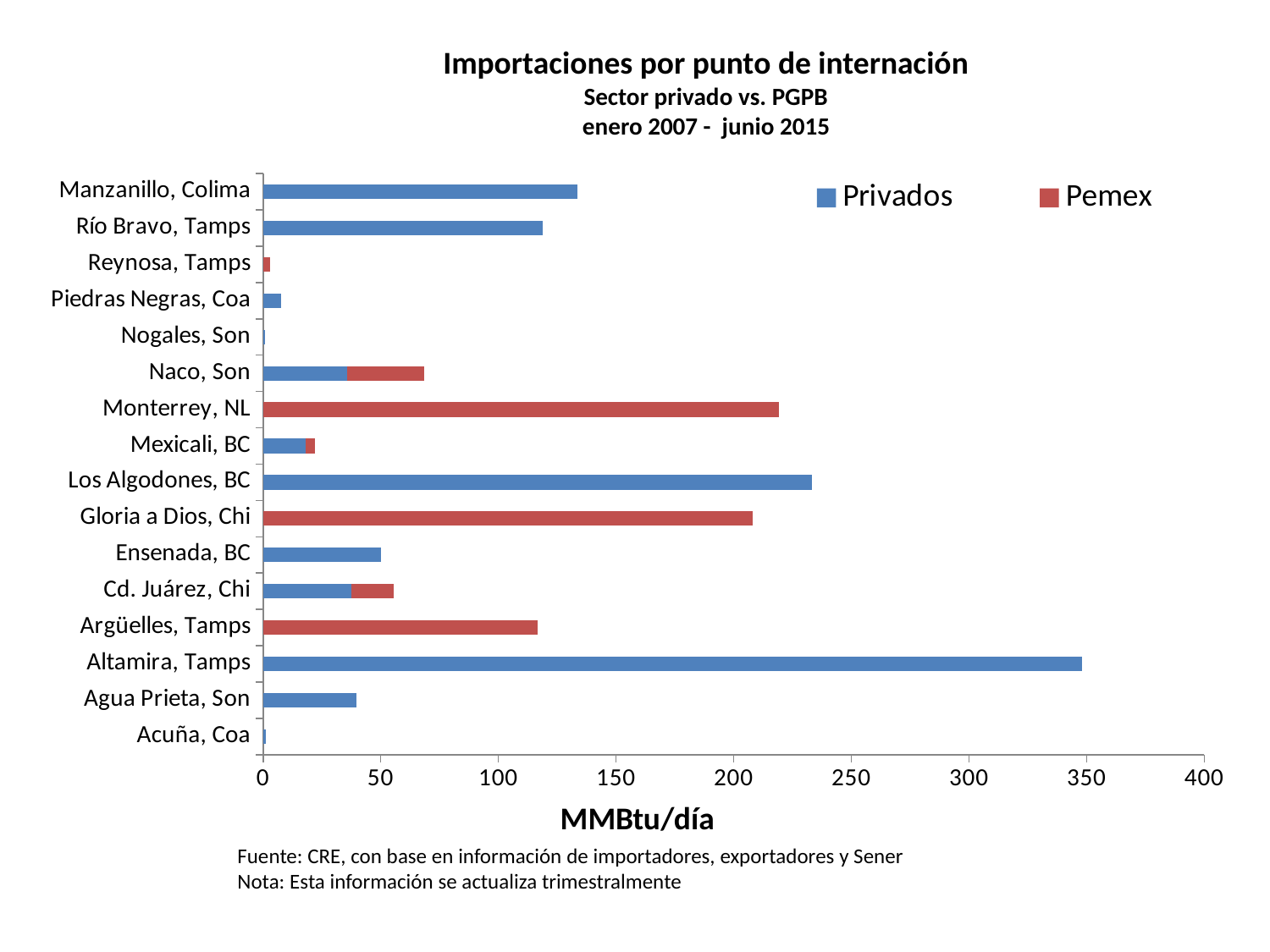
Is the value for Manzanillo, Colima greater or less than 100? greater Is the total value for Altamira, Tamps greater or less than 300? greater What unit is given on the x axis label? MMBtu/día Which import point has the highest total value? Altamira, Tamps Is the total value for Naco, Son greater or less than 50? greater Which is larger, the total for Altamira, Tamps or the total for Los Algodones, BC? Altamira, Tamps Which series is shown in red in the legend? Pemex What kind of chart is shown on the slide? bar chart How many series does the legend list? 2 How many import points (categories) are shown on the y axis? 16